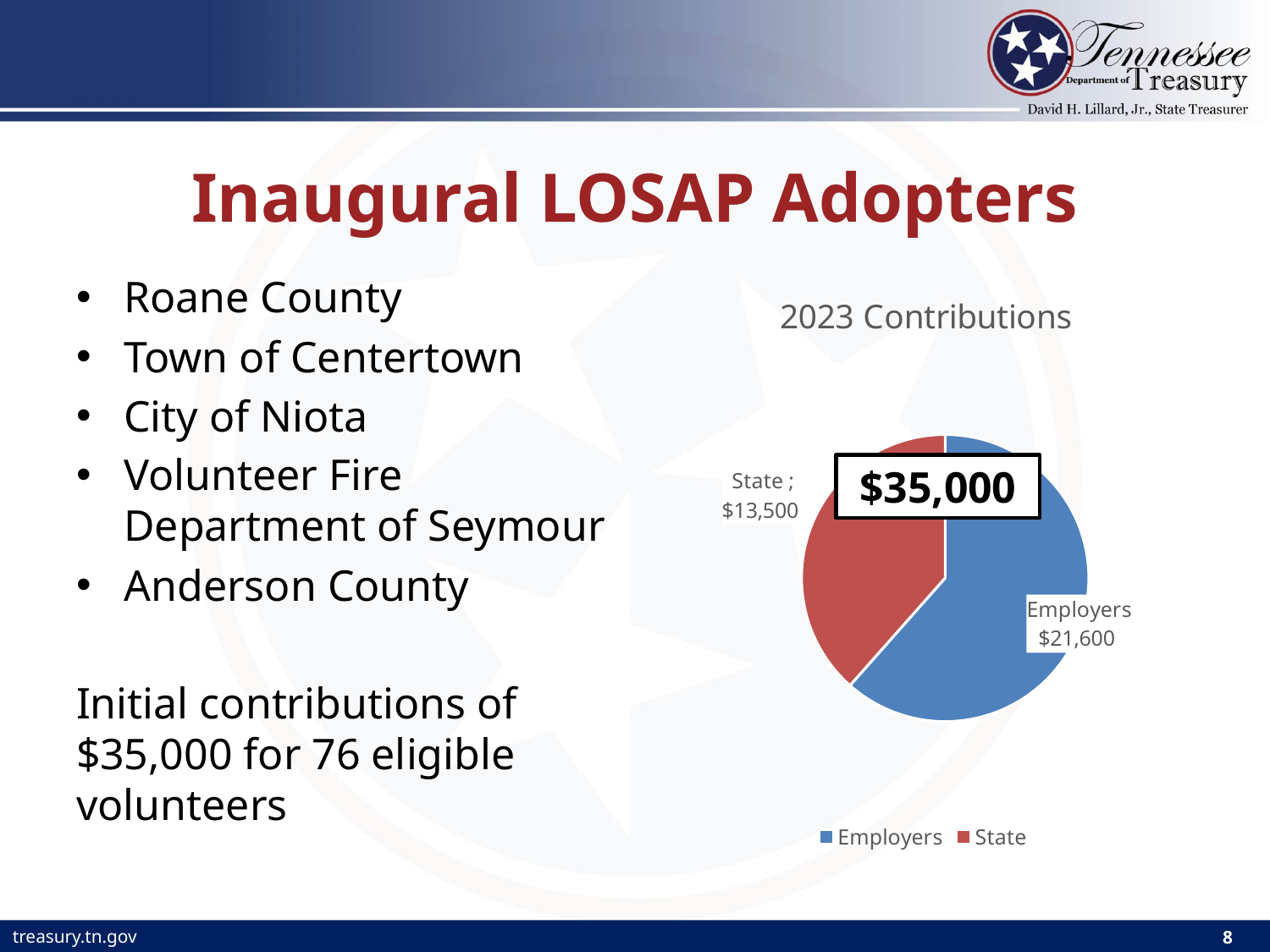
In the 2023 Contributions chart, what colour is the State slice? Red In the 2023 Contributions chart, which is larger: Employers or State? Employers Which slice of the 2023 Contributions pie chart is the largest? Employers How many slices does the 2023 Contributions pie chart have? 2 In the 2023 Contributions chart, what is the value for State? $13,500 What is the title of the chart on the slide? 2023 Contributions In the 2023 Contributions chart, what is the value for Employers? $21,600 How many entries does the legend of the 2023 Contributions chart list? 2 Which slice of the 2023 Contributions pie chart is the smallest? State In the 2023 Contributions chart, what is the difference between the Employers and State contributions? $8,100 What kind of chart is shown on the slide? Pie chart What is the total of the contributions shown in the 2023 Contributions pie chart? $35,100